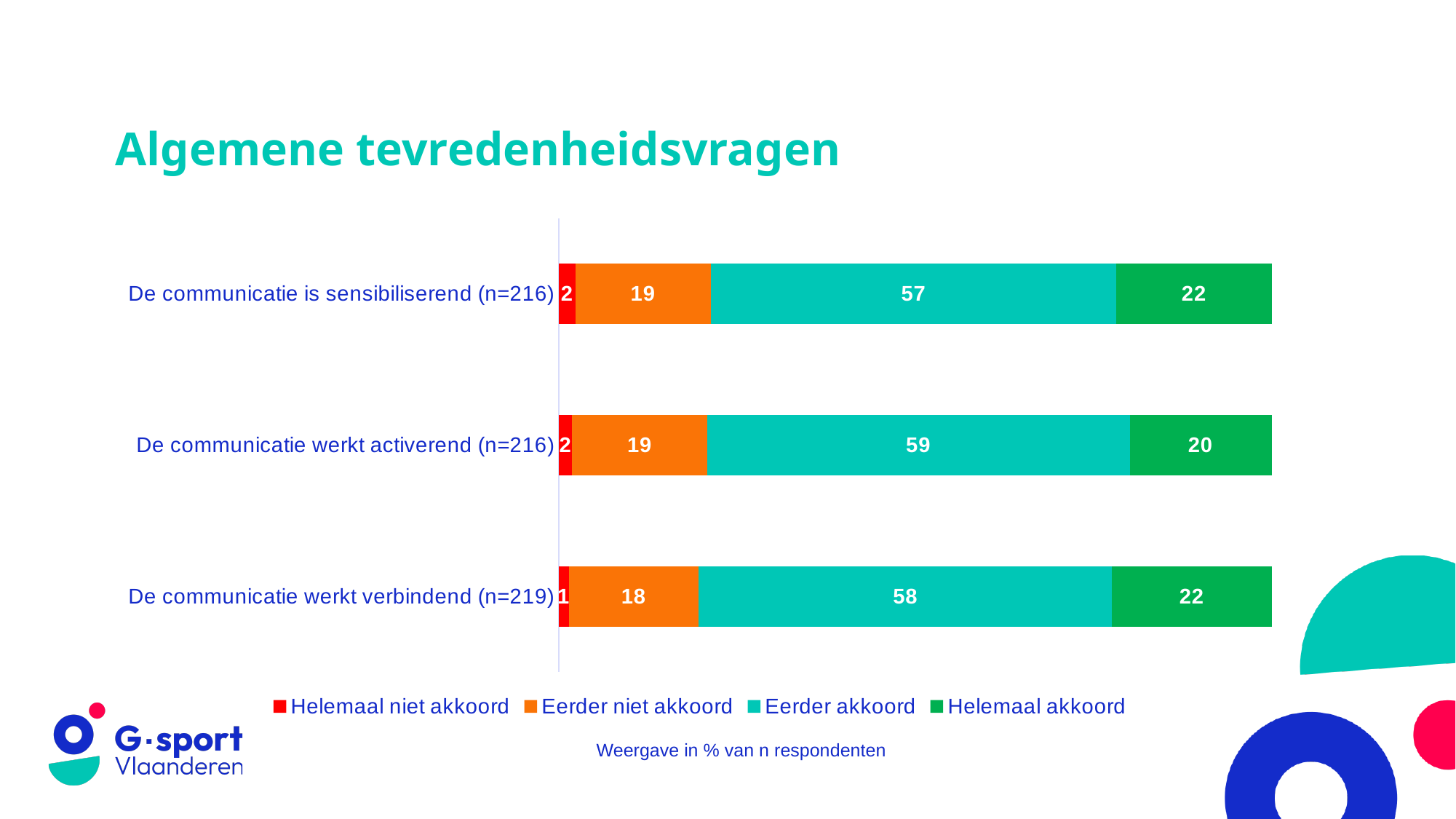
What is the total of the stacked bar for 'De communicatie is sensibiliserend (n=216)'? 100 How many categories are shown in the chart? 3 What is the value for 'Eerder niet akkoord' for 'De communicatie werkt verbindend (n=219)'? 18 What is the value for 'Helemaal akkoord' for 'De communicatie is sensibiliserend (n=216)'? 22 How many series does the legend list? 4 Which category has the highest value for 'Eerder akkoord'? De communicatie werkt activerend (n=216) What is the value for 'Eerder akkoord' for 'De communicatie werkt activerend (n=216)'? 59 Which category has the lowest value for 'Helemaal akkoord'? De communicatie werkt activerend (n=216) What is the value for 'Helemaal niet akkoord' for 'De communicatie werkt verbindend (n=219)'? 1 What kind of chart is shown on the slide? Stacked bar chart For 'De communicatie is sensibiliserend (n=216)', what is the difference between the 'Eerder akkoord' value and the 'Eerder niet akkoord' value? 38 Which has a larger 'Helemaal akkoord' value: 'De communicatie is sensibiliserend (n=216)' or 'De communicatie werkt activerend (n=216)'? De communicatie is sensibiliserend (n=216)